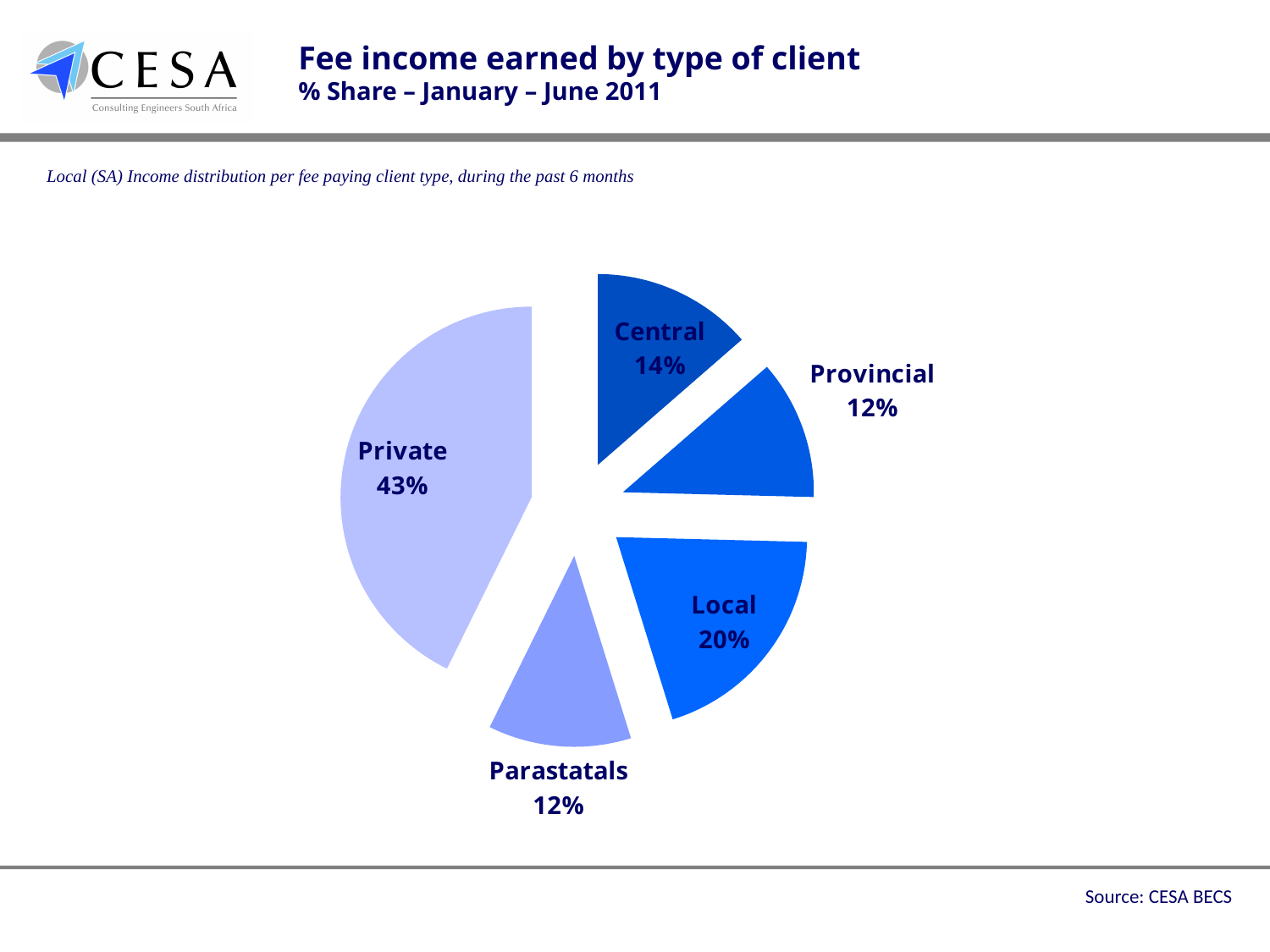
What share of fee income is earned from Private clients? 43% What kind of chart is shown on the slide? Pie chart What is the difference in share between Central and Provincial clients? 2% Which has a larger share of fee income, Local or Central? Local What is the difference in share between Private and Local clients? 23% What is the title of the chart? Fee income earned by type of client How many client types are shown in the pie chart? 5 What share of fee income is earned from Local clients? 20% Which client type has the largest share of fee income? Private What share of fee income is earned from Provincial clients? 12% What share of fee income is earned from Central clients? 14% What share of fee income is earned from Parastatals? 12%